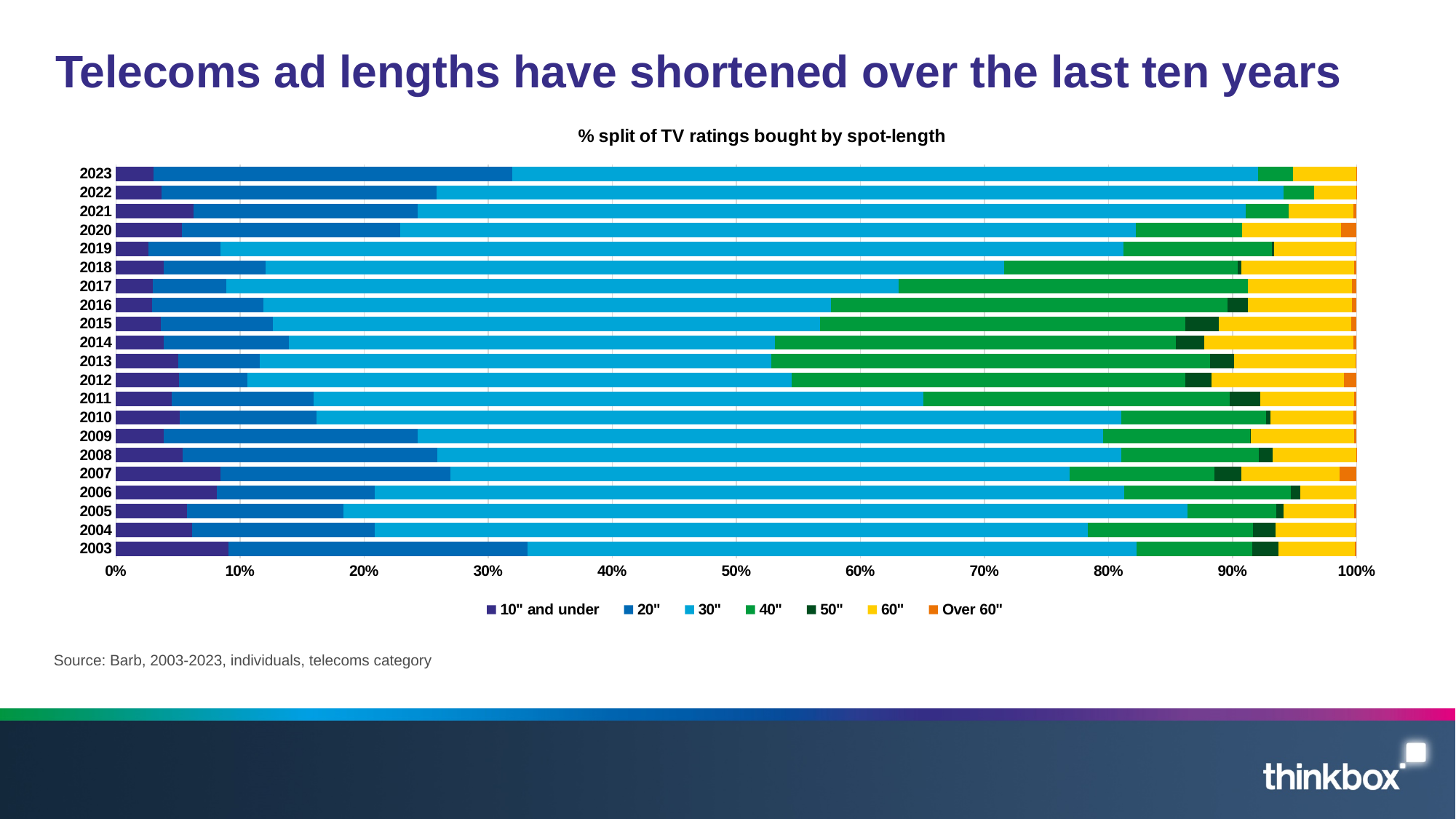
Is the 40" share for 2023 greater or less than 10%? less What kind of chart is shown on the slide? Stacked bar chart Which year has the largest 20" share? 2023 Is the 20" share for 2023 greater or less than 20%? greater What is the title of the chart? % split of TV ratings bought by spot-length How many years are plotted on the chart? 21 Which legend entry is shown in orange? Over 60" Which year has the larger 40" share, 2016 or 2023? 2016 Does the 40" share rise or fall from 2016 to 2023? fall How many series does the legend list? 7 Is the 20" share for 2019 greater or less than 10%? less